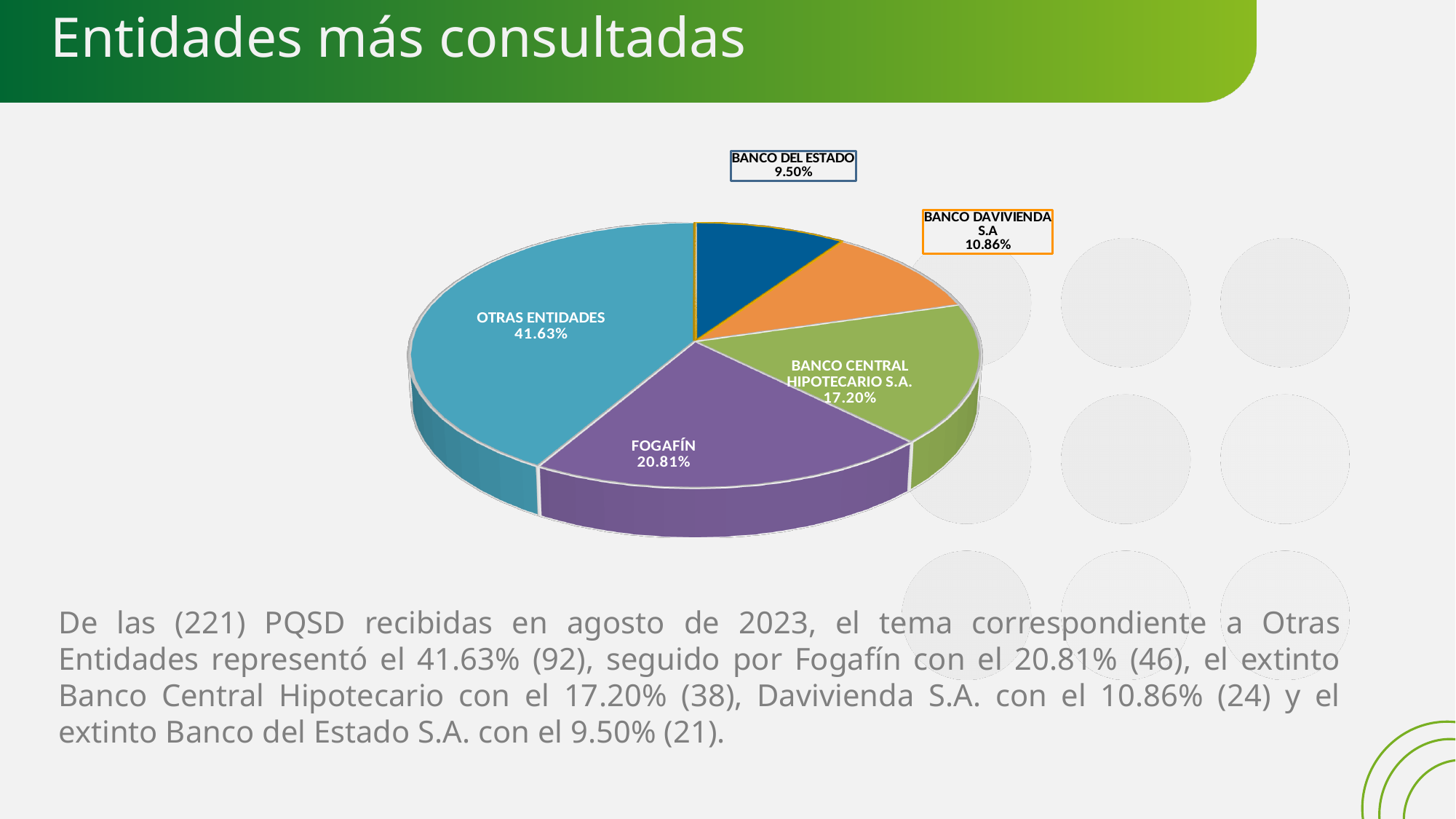
What is the value shown for BANCO DEL ESTADO? 9.50% What colour is the slice for FOGAFÍN? Purple Which category has the smallest slice of the pie? BANCO DEL ESTADO How many slices does the pie chart have? 5 What share of the pie does OTRAS ENTIDADES represent? 41.63% Which category has the largest slice of the pie? OTRAS ENTIDADES What kind of chart is shown on the slide? Pie chart Which is larger, the share for FOGAFÍN or the share for BANCO CENTRAL HIPOTECARIO S.A.? FOGAFÍN What is the value shown for BANCO CENTRAL HIPOTECARIO S.A.? 17.20% What is the difference in percentage points between OTRAS ENTIDADES and FOGAFÍN? 20.82 What is the value shown for FOGAFÍN? 20.81% What is the value shown for BANCO DAVIVIENDA S.A? 10.86%